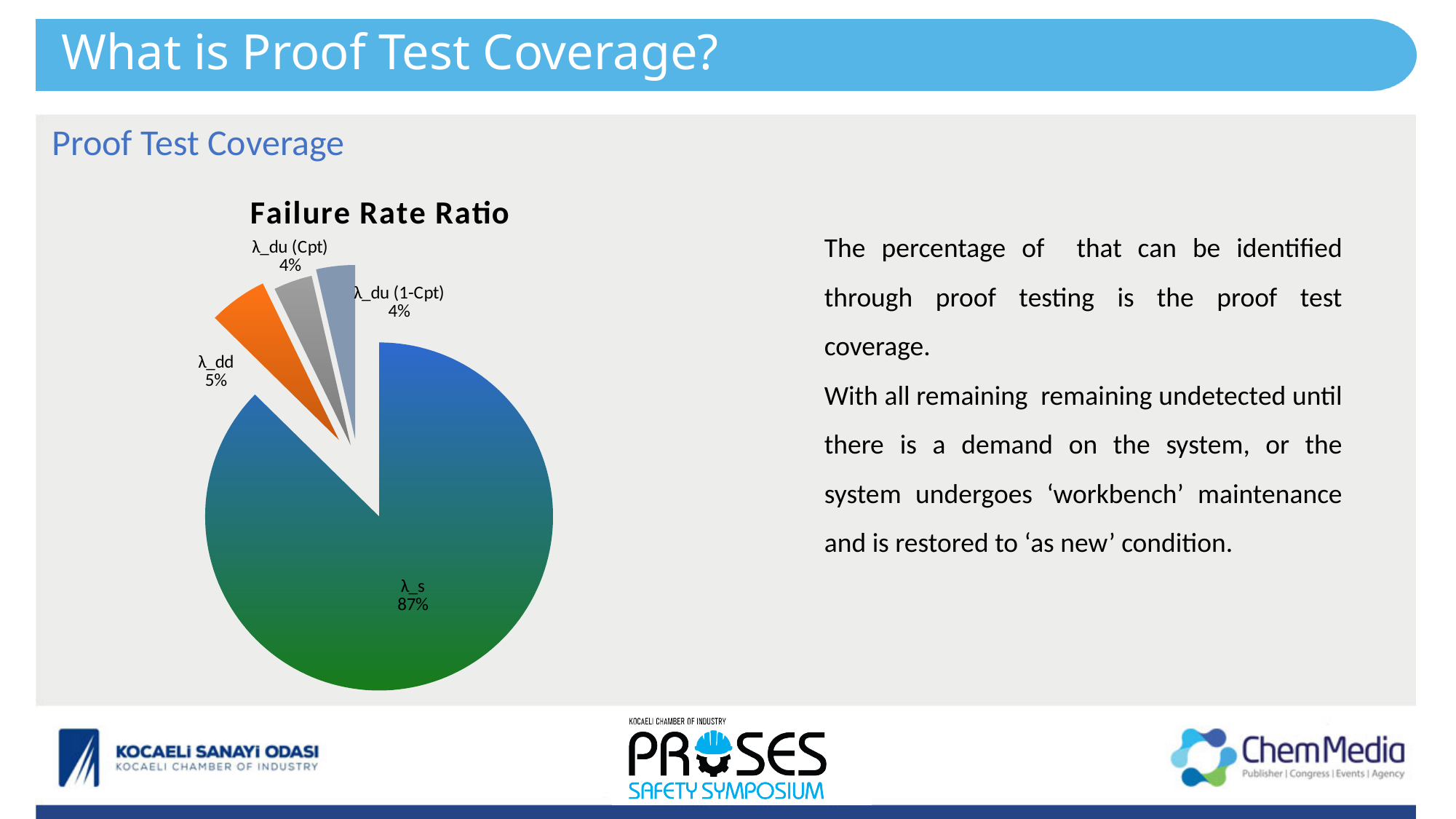
Which is larger, the λ_dd slice or the λ_du (Cpt) slice? λ_dd What is the title of the chart? Failure Rate Ratio What is the difference in percentage points between the λ_s slice and the λ_dd slice? 82 What percentage does the λ_s slice represent? 87% How many slices does the pie chart have? 4 What type of chart is shown on the slide? pie chart What percentage does the λ_du (1-Cpt) slice represent? 4% What colour is the λ_dd slice? orange What percentage does the λ_dd slice represent? 5% What is the combined share of the λ_du (Cpt) and λ_du (1-Cpt) slices? 8% Which slice is the largest in the pie chart? λ_s What percentage does the λ_du (Cpt) slice represent? 4%